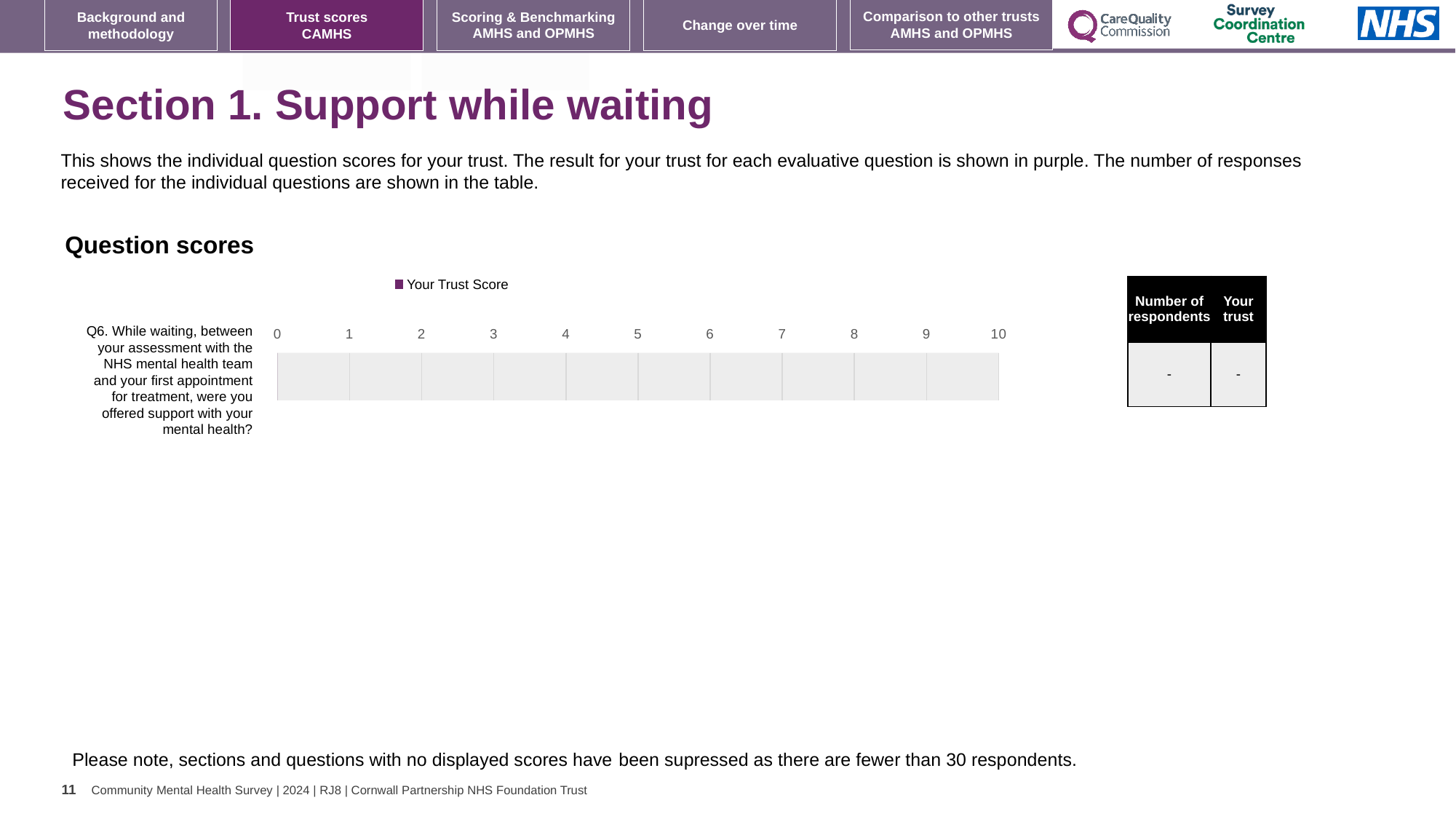
What is the name of the series shown in the legend of the "Question scores" chart? Your Trust Score How many series does the legend of the "Question scores" chart list? 1 What is the highest value shown on the x axis of the "Question scores" chart? 10 What value is shown in the "Your trust" column of the table for Q6? - What value is shown in the "Number of respondents" column of the table for Q6? - How many questions (categories) are listed on the y axis of the "Question scores" chart? 1 What kind of chart is shown under the heading "Question scores"? bar chart Is a bar plotted for Q6 in the "Question scores" chart, or is the score suppressed? suppressed